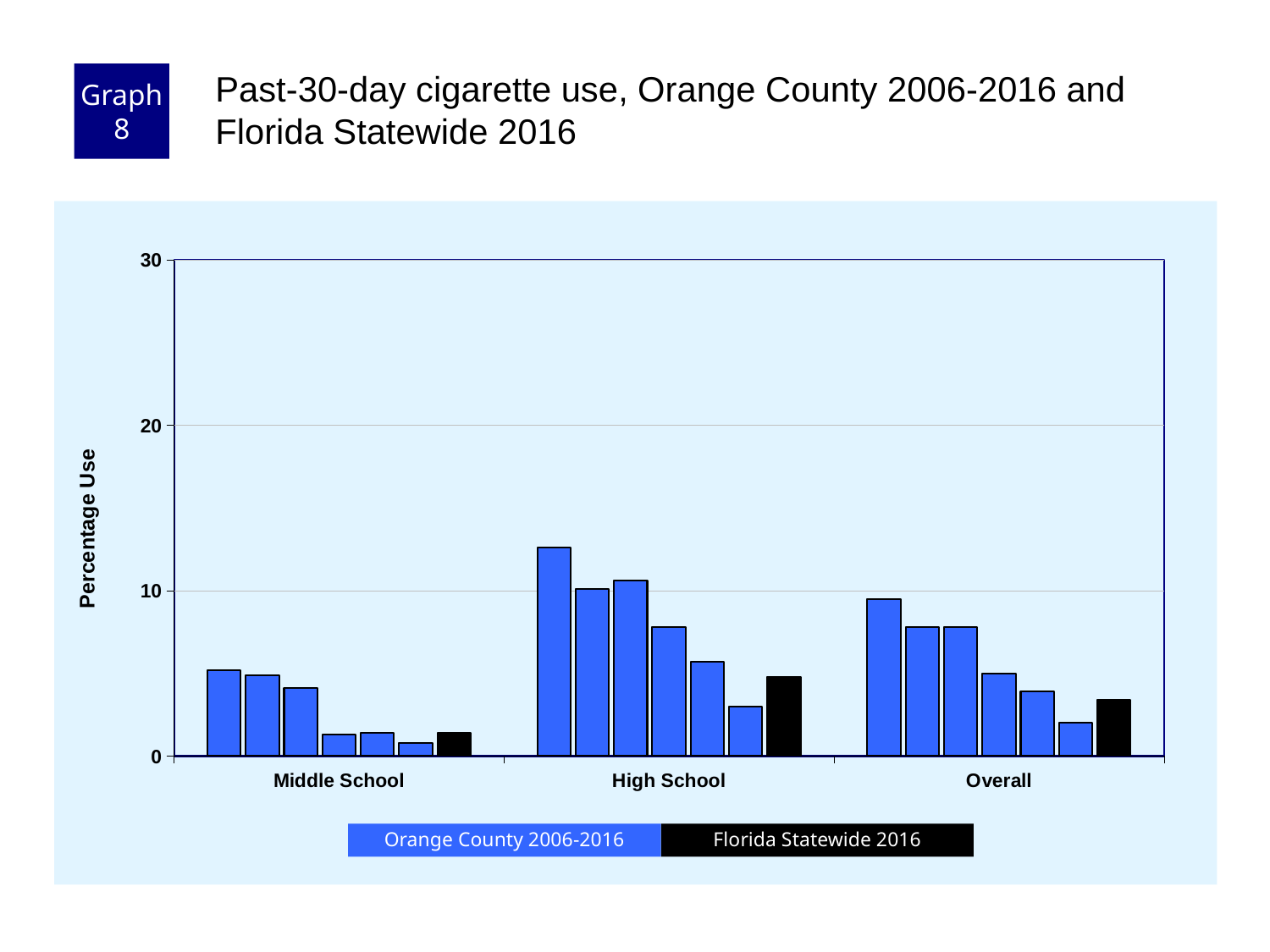
Is the value for Florida Statewide 2016 in the High School group greater or less than 10? less Which school-level group has the lowest bars? Middle School Do the Orange County bars in the Middle School group generally rise or fall from left to right? fall What are the two series named in the legend? Orange County 2006-2016 and Florida Statewide 2016 How many school-level categories are shown on the x axis? 3 What is the label on the y axis? Percentage Use Which is larger, the Florida Statewide 2016 value for High School or for Middle School? High School Which school-level group has the tallest bar overall? High School Is the value for the tallest Orange County bar in the High School group greater or less than 10? greater How many series does the legend list? 2 What kind of chart is shown on the slide? Bar chart Is the value for Florida Statewide 2016 in the Middle School group greater or less than 10? less